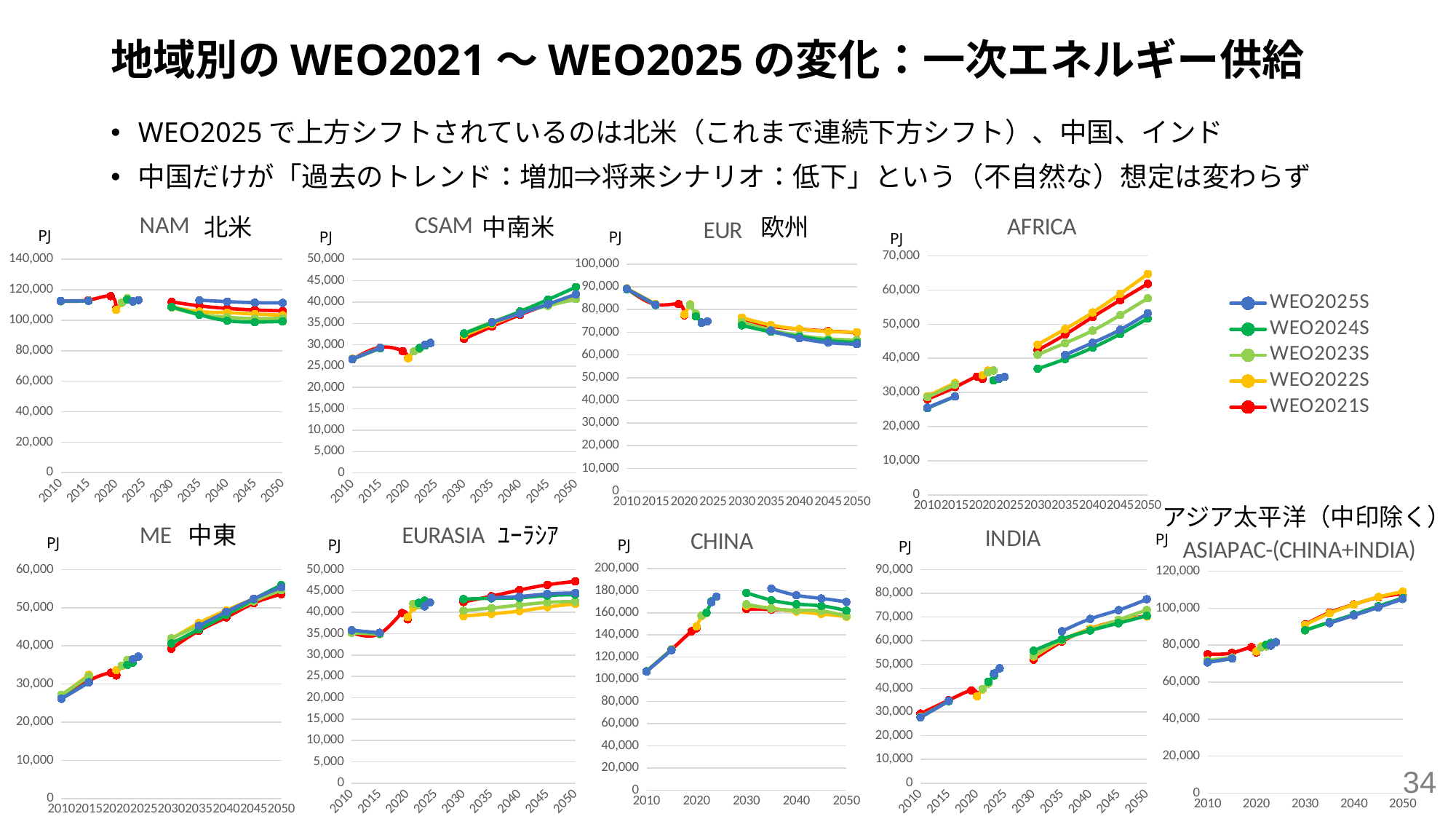
In the NAM 北米 chart, which is larger in 2050, WEO2025S or WEO2024S? WEO2025S In the AFRICA chart, which series has the highest value in 2050? WEO2022S In the EURASIA chart, which series has the highest value in 2050? WEO2021S In the AFRICA chart, is the WEO2022S value in 2050 greater or less than 60,000? greater What kind of chart is used for the NAM 北米 panel? line chart What unit is shown on the vertical axis of the charts? PJ In the INDIA chart, does the WEO2025S series rise or fall from 2030 to 2050? rise In the EUR 欧州 chart, is the WEO2025S value in 2050 greater or less than 70,000? less In the CHINA chart, is the WEO2025S value in 2050 greater or less than 160,000? greater How many regional charts are shown on the slide? 9 In the CHINA chart, does the WEO2025S series rise or fall from 2035 to 2050? fall How many series does the legend list? 5